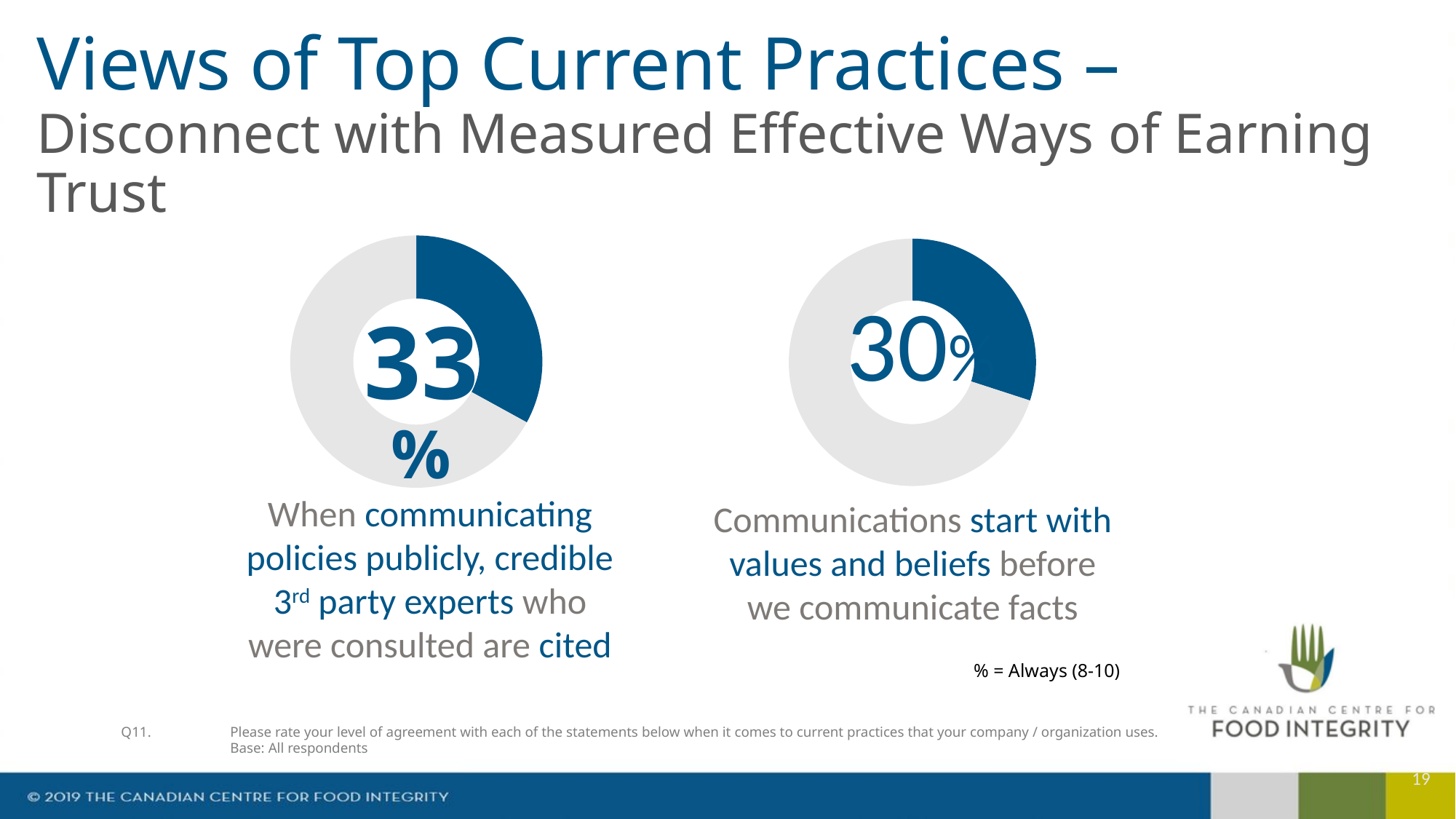
How many doughnut charts are shown on the slide? 2 What kind of chart is used on the right side of the slide? Doughnut chart On the left chart, what percentage of respondents say credible 3rd party experts who were consulted are cited when communicating policies publicly? 33% According to the note on the slide, what does the percentage in each chart represent? Always (8-10) Is the value shown on the left chart greater or less than 50%? less What colour is used for the highlighted (filled) portion of each doughnut chart? Blue What kind of chart is used on the left side of the slide? Doughnut chart Is the value shown on the right chart greater or less than 25%? greater Which practice has the higher percentage: citing credible 3rd party experts (left chart) or starting communications with values and beliefs (right chart)? Citing credible 3rd party experts On the right chart, what percentage of respondents say communications start with values and beliefs before communicating facts? 30% What is the difference in percentage points between the left chart (33%) and the right chart (30%)? 3 percentage points